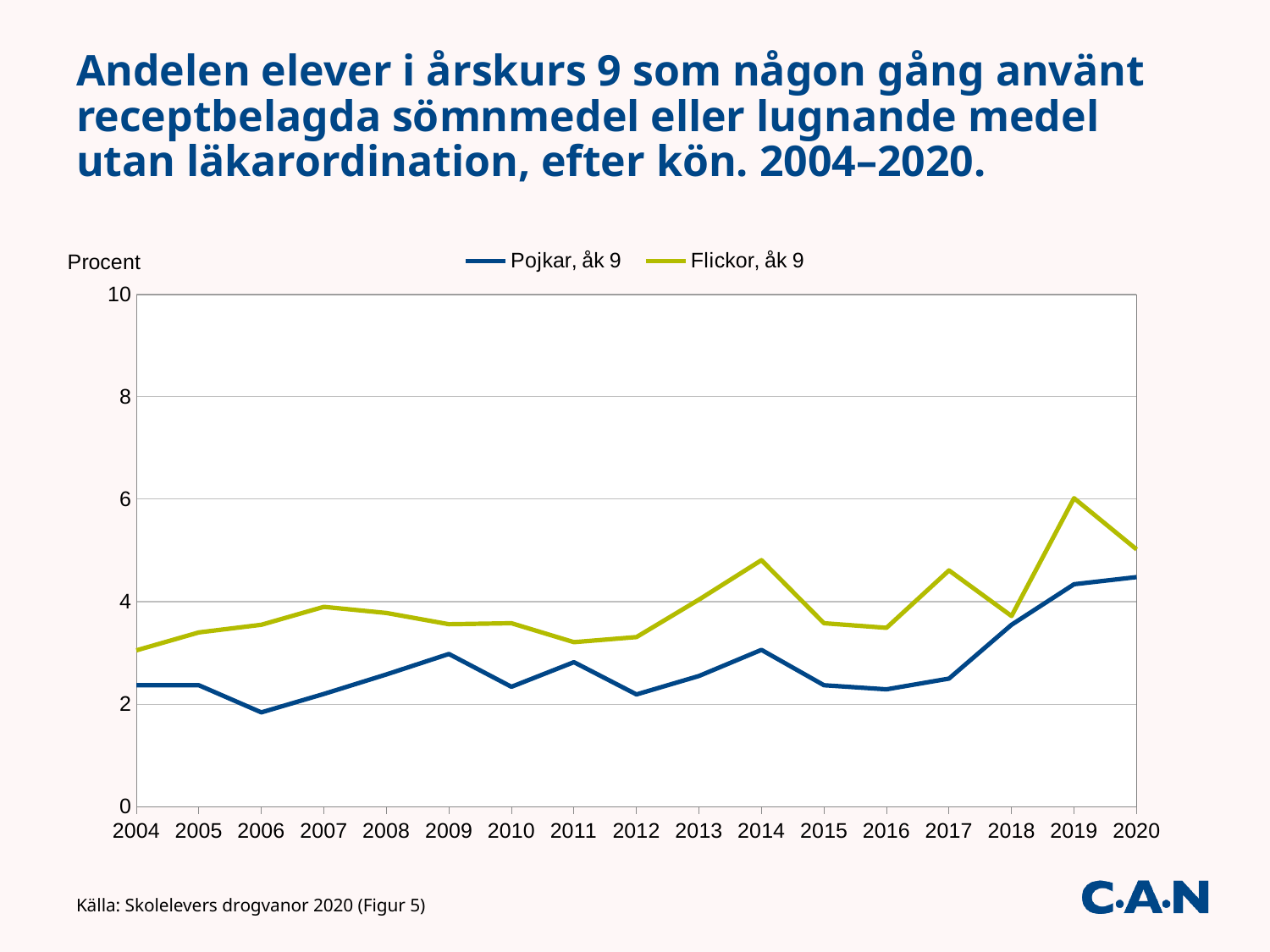
In 2010, which series has the larger value, Pojkar, åk 9 or Flickor, åk 9? Flickor, åk 9 Does the Pojkar, åk 9 series rise or fall from 2017 to 2019? rise How many years are plotted along the x axis? 17 In which year does the Flickor, åk 9 series reach its highest value? 2019 Is the value for Flickor, åk 9 in 2014 greater or less than 4? greater What label is shown on the y axis of the chart? Procent Is the value for Flickor, åk 9 in 2019 greater or less than 4? greater How many series does the legend list? 2 Is the value for Pojkar, åk 9 in 2006 greater or less than 2? less What kind of chart is shown on the slide? line chart In which year does the Pojkar, åk 9 series reach its lowest value? 2006